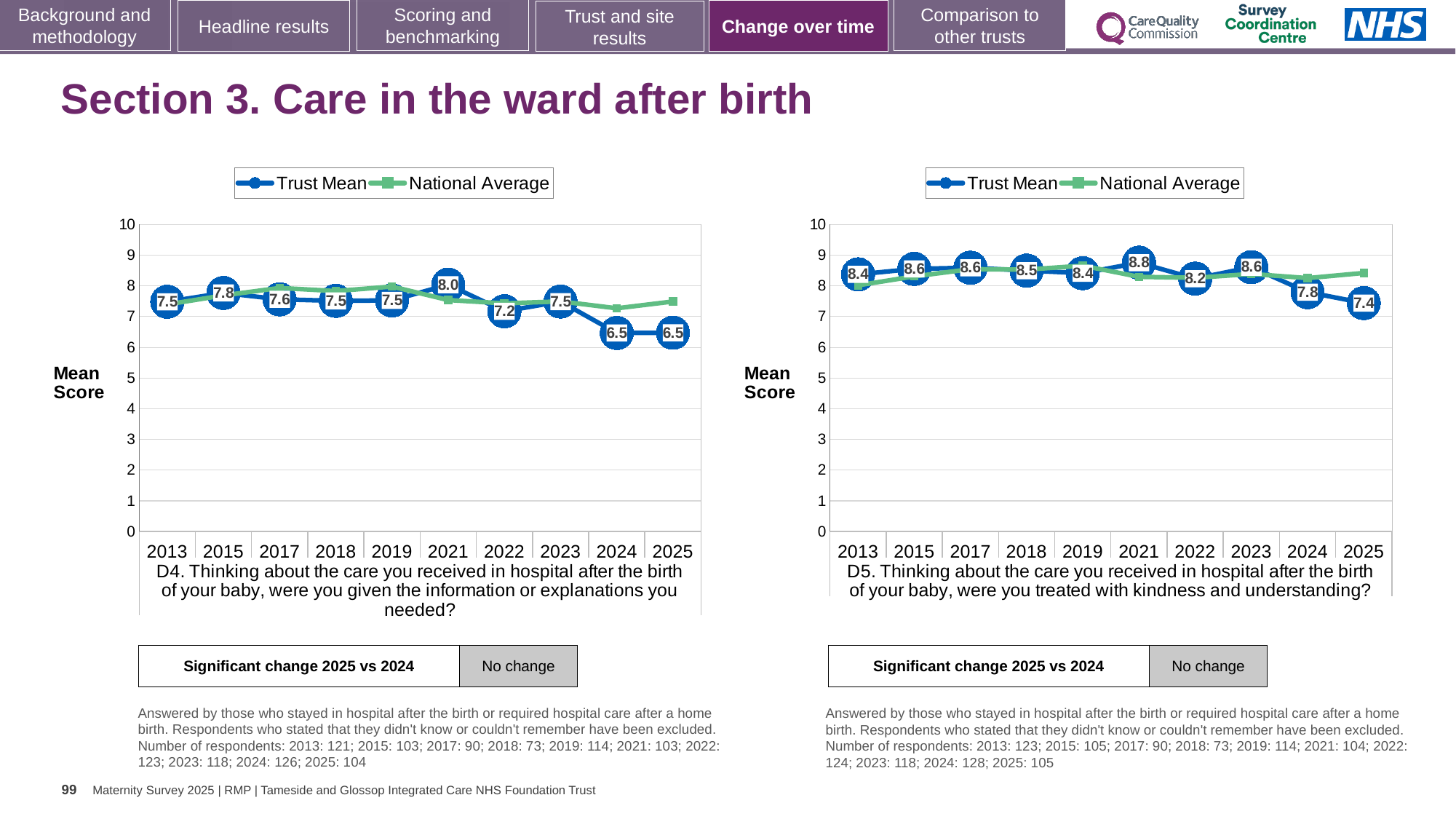
In the D4 chart on the left, which year has the highest Trust Mean score? 2021 How many years are plotted on the x axis of the D5 chart on the right? 10 In the D5 chart on the right, what is the difference between the Trust Mean scores for 2021 and 2025? 1.4 In the D5 chart on the right, what is the Trust Mean score for 2021? 8.8 In the D4 chart on the left, is the National Average value for 2025 greater or less than 7? greater How many series does the legend of the D4 chart on the left list? 2 In the D4 chart on the left, is the Trust Mean score for 2015 or 2022 larger? 2015 In the D5 chart on the right, which year has the lowest Trust Mean score? 2025 In the D5 chart on the right, what is the Trust Mean score for 2025? 7.4 What type of chart is the D5 chart on the right? Line chart In the D4 chart on the left, what is the Trust Mean score for 2021? 8.0 In the D4 chart on the left, what is the Trust Mean score for 2025? 6.5